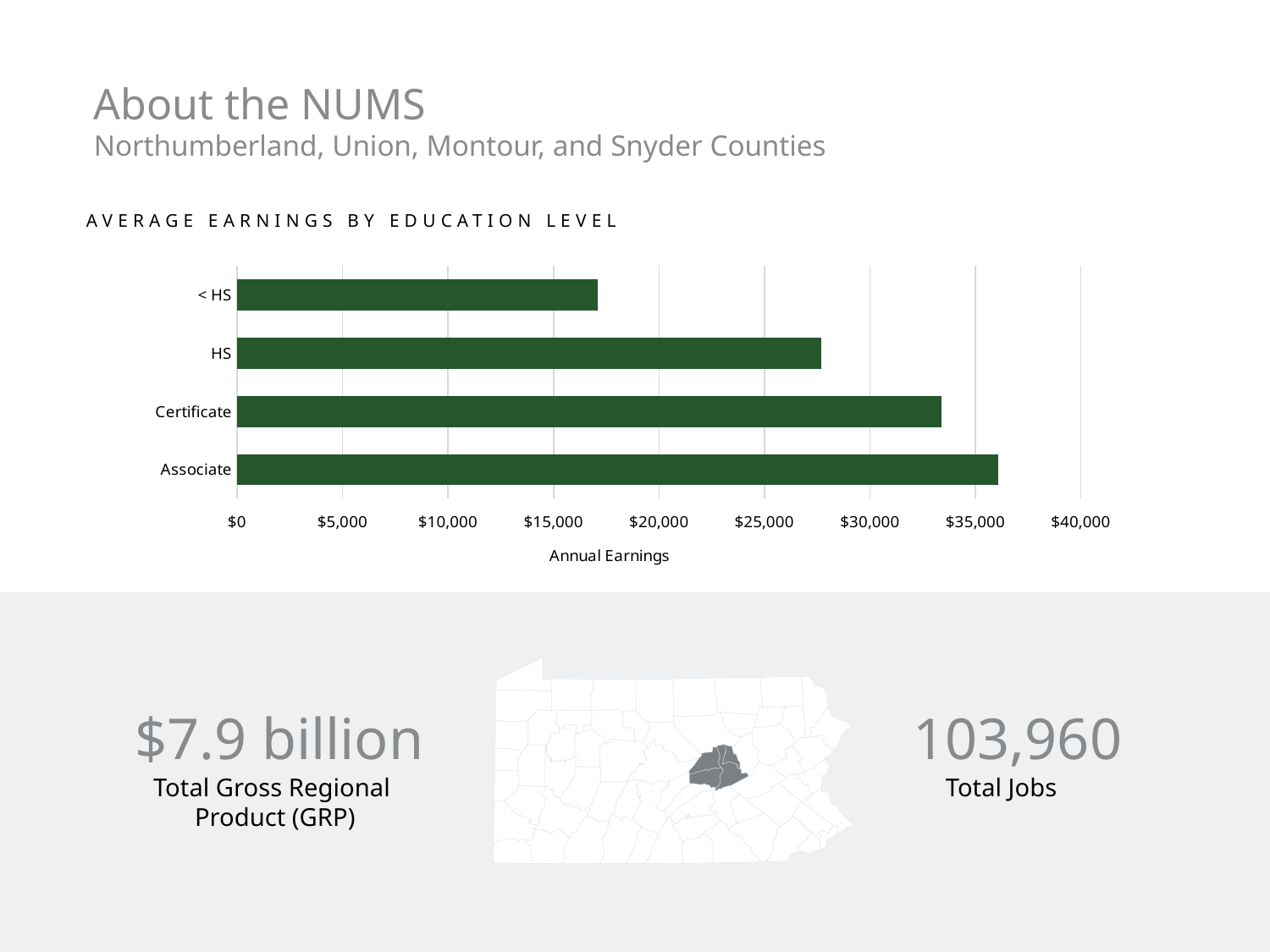
How many education levels are plotted in the chart? 4 Is the value for Certificate greater or less than $30,000? greater What is the label on the horizontal axis of the chart? Annual Earnings Is the value for < HS greater or less than $20,000? less Which education level has the lowest average earnings? < HS What is the maximum value shown on the horizontal axis of the chart? $40,000 Is the value for Associate greater or less than $35,000? greater Which has higher average earnings, HS or Certificate? Certificate Which has lower average earnings, < HS or Associate? < HS Which education level has the highest average earnings? Associate What kind of chart is shown under "Average Earnings by Education Level"? bar chart